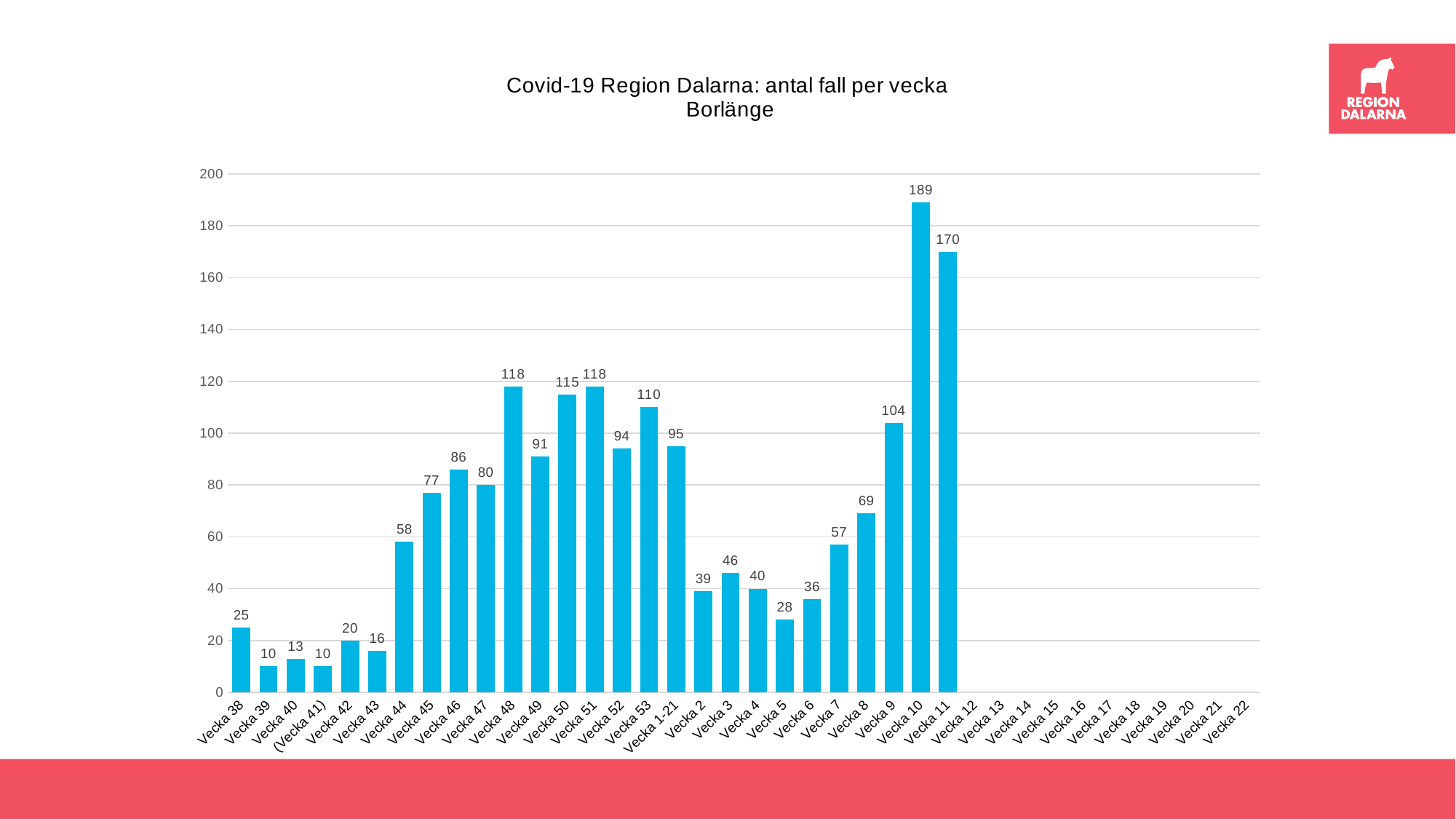
Do the values rise or fall from Vecka 5 to Vecka 10? Rise What kind of chart is shown on the slide? Bar chart What is the value for Vecka 48? 118 What is the value for Vecka 1-21? 95 Which week has the highest number of cases? Vecka 10 Is the value for Vecka 9 greater or less than 100? greater What is the value for Vecka 5? 28 What is the title of the chart? Covid-19 Region Dalarna: antal fall per vecka Borlänge How many weeks have a bar plotted on the chart? 27 What is the difference between the values for Vecka 10 and Vecka 11? 19 What is the lowest value shown on the chart? 10 Which is larger, the value for Vecka 45 or the value for Vecka 47? Vecka 47